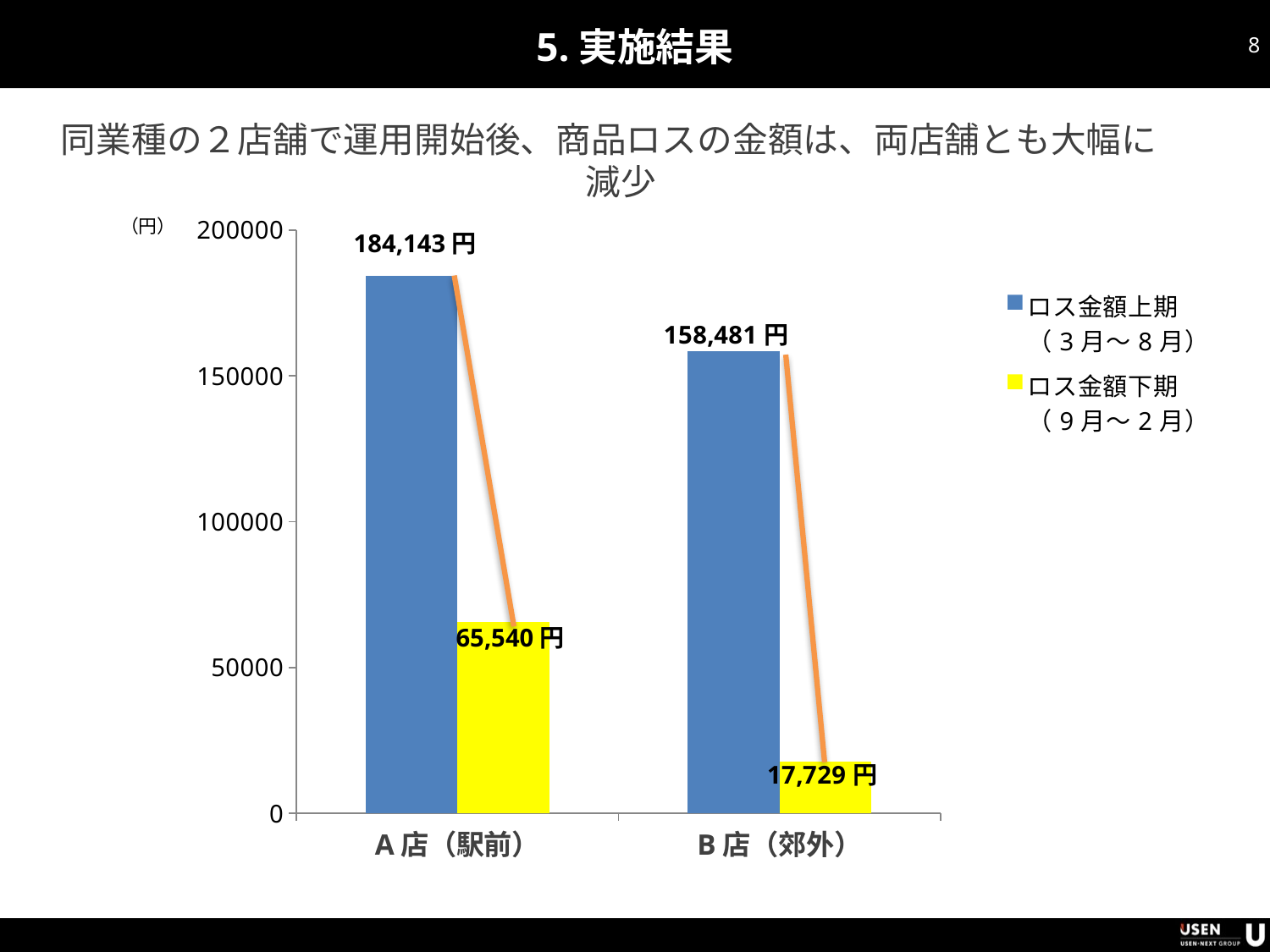
What is the difference between ロス金額上期 and ロス金額下期 for A店（駅前）? 118,603 円 Which bar in the chart has the highest value? A店（駅前） ロス金額上期（3月～8月） Which store has the larger ロス金額上期（3月～8月） value, A店（駅前） or B店（郊外）? A店（駅前） Which bar in the chart has the lowest value? B店（郊外） ロス金額下期（9月～2月） What is the value of ロス金額下期（9月～2月） for A店（駅前）? 65,540 円 What is the difference between ロス金額上期 and ロス金額下期 for B店（郊外）? 140,752 円 What is the value of ロス金額下期（9月～2月） for B店（郊外）? 17,729 円 How many series does the legend list? 2 Is the ロス金額上期 value for B店（郊外） greater or less than 150000? greater What is the value of ロス金額上期（3月～8月） for A店（駅前）? 184,143 円 What kind of chart is shown on the slide? bar chart How many store categories are shown on the x axis? 2